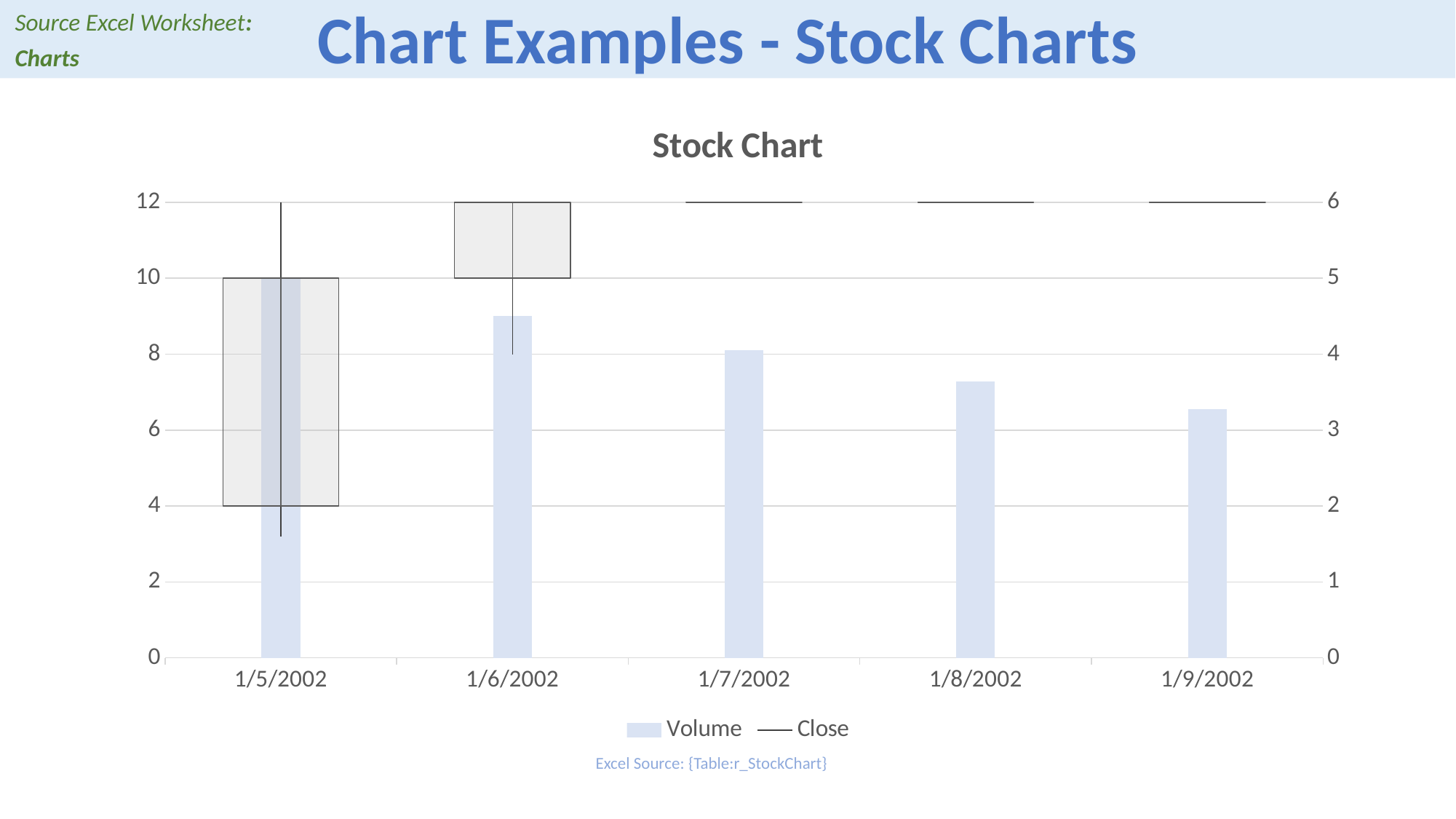
How many series does the chart legend list? 2 Which has the larger Volume bar, 1/6/2002 or 1/8/2002? 1/6/2002 How many dates are shown on the x axis of the chart? 5 Which two series are named in the chart legend? Volume and Close Do the Volume bars rise or fall from 1/5/2002 to 1/9/2002? fall What is the title of the chart on the slide? Stock Chart Is the Volume value for 1/6/2002 greater or less than 8? greater Which date has the highest Volume bar? 1/5/2002 Which date has the lowest Volume bar? 1/9/2002 Is the Volume value for 1/9/2002 greater or less than 6? greater Is the Volume value for 1/8/2002 greater or less than 8? less What is the Volume value for 1/5/2002? 10